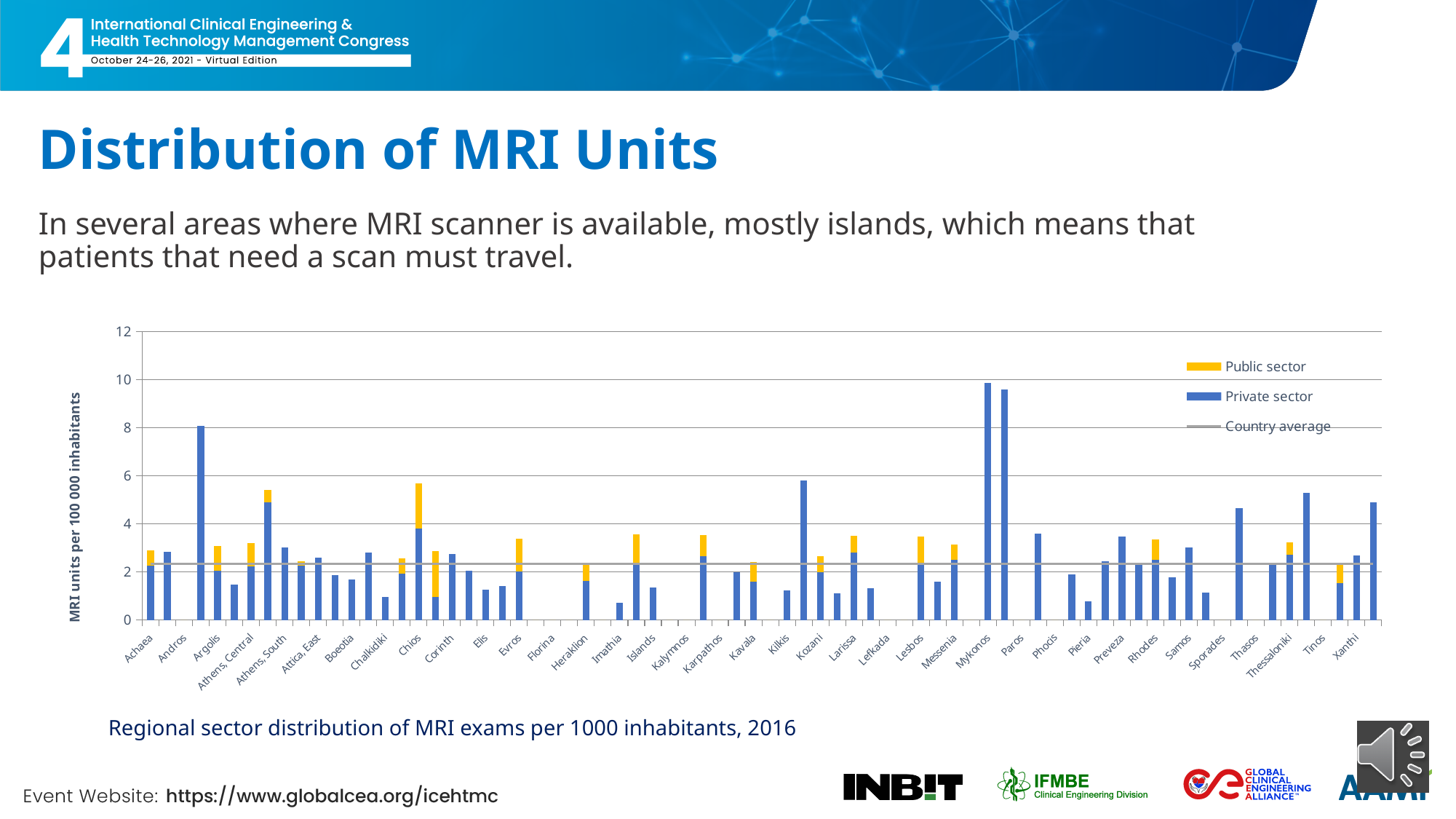
Is the tallest bar in the chart greater or less than 8? greater Is the country average line in the chart greater or less than 4? less What is the label on the vertical axis of the chart? MRI units per 100 000 inhabitants How many entries does the chart legend list? 3 Which series is shown in yellow in the chart? Public sector What kind of chart is shown on the slide? bar chart